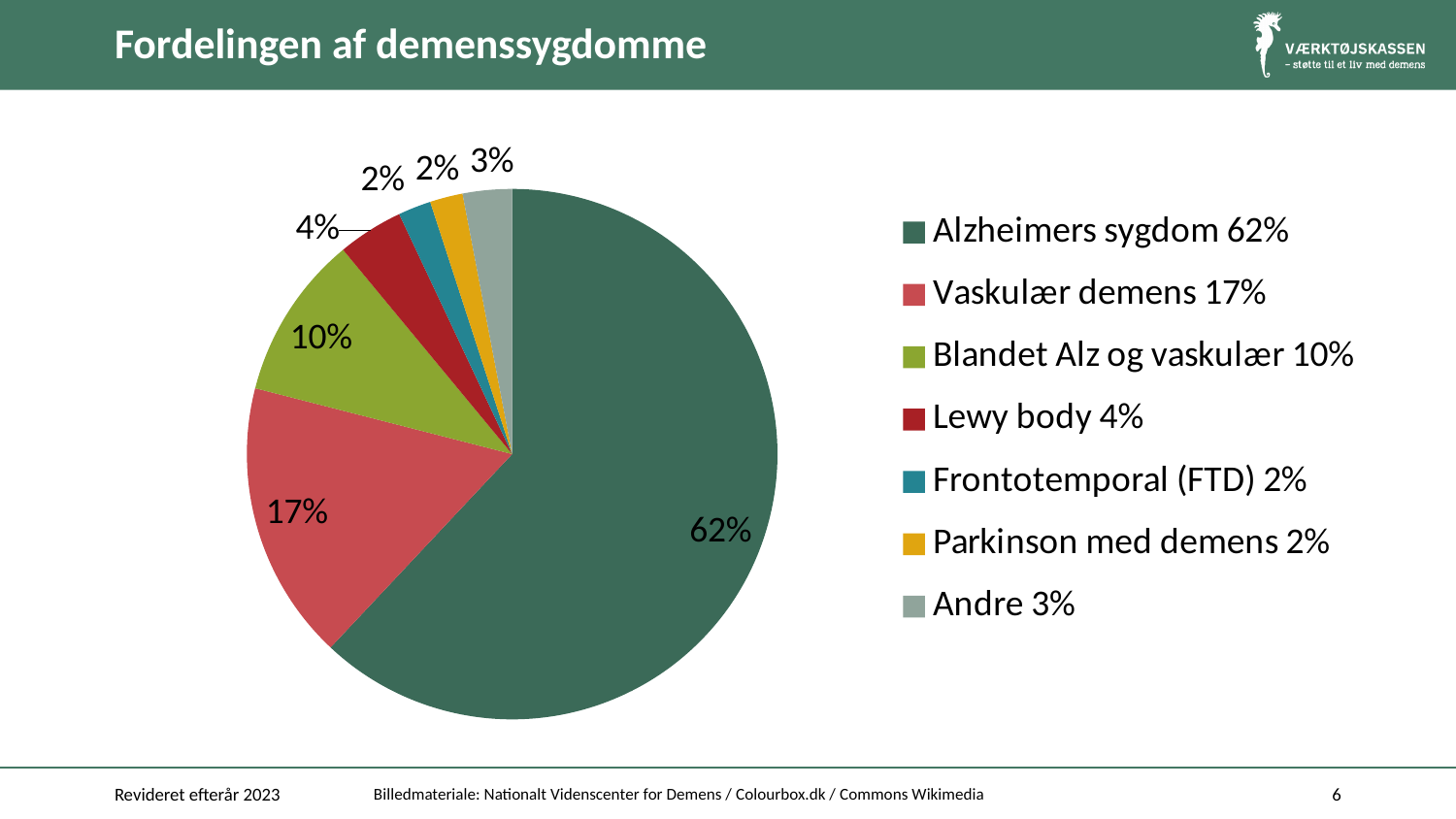
What is the difference between the shares of Alzheimers sygdom and Vaskulær demens? 45% What is the value shown for Andre? 3% Which is larger, the share for Blandet Alz og vaskulær or the share for Lewy body? Blandet Alz og vaskulær What colour is the slice for Parkinson med demens? yellow What is the value shown for Lewy body? 4% How many categories does the legend list? 7 What is the value shown for Blandet Alz og vaskulær? 10% What kind of chart is shown on the slide? pie chart What share of the pie does Alzheimers sygdom have? 62% What is the value shown for Vaskulær demens? 17% What is the title of the chart on the slide? Fordelingen af demenssygdomme Which category has the largest slice of the pie? Alzheimers sygdom